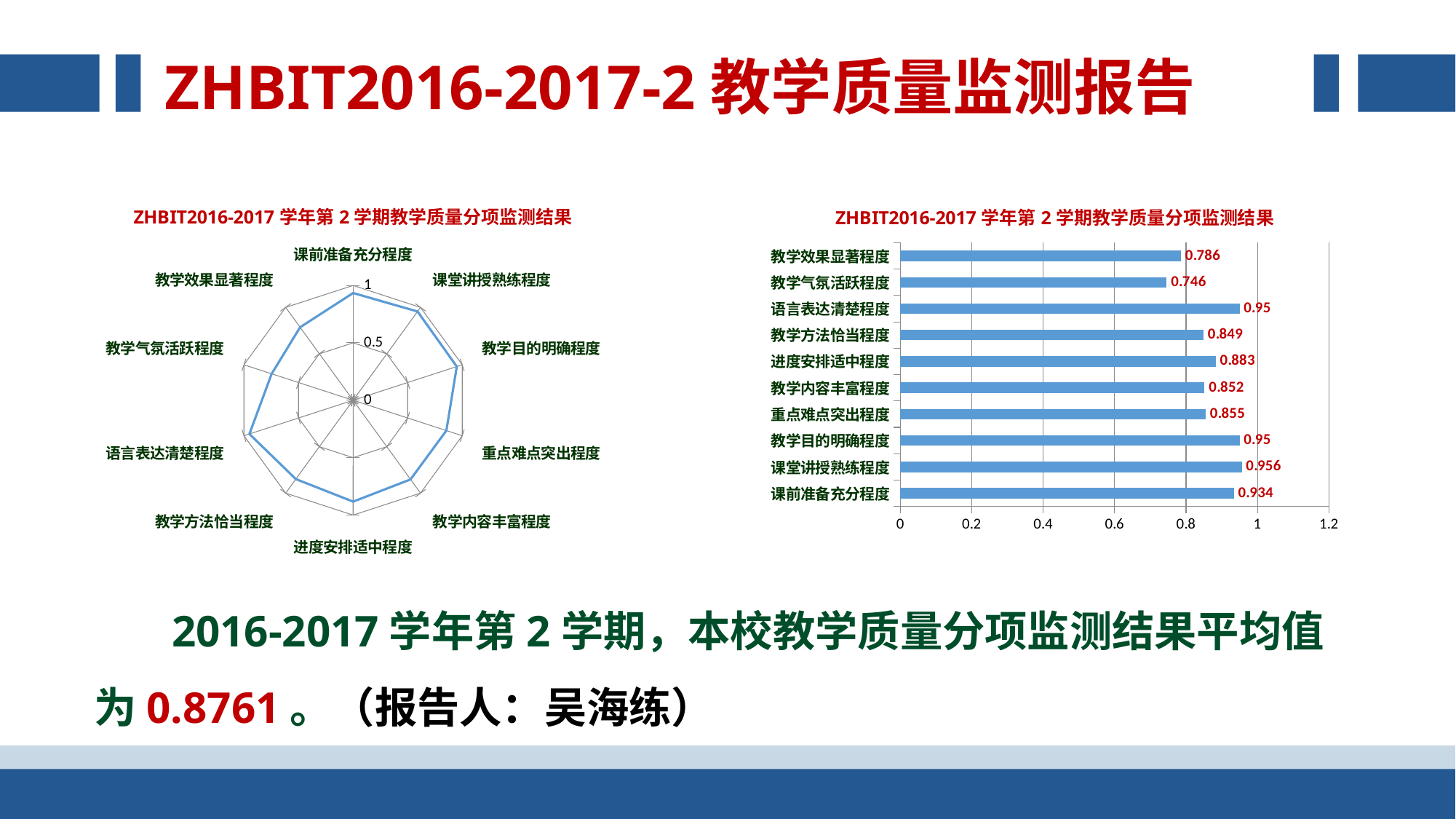
What kind of chart is the chart on the right side of the slide? bar chart In the bar chart on the right, what is the difference between the values for 进度安排适中程度 and 教学方法恰当程度? 0.034 In the bar chart on the right, is the value for 教学效果显著程度 greater or less than 0.8? less In the bar chart on the right, what is the value for 教学气氛活跃程度? 0.746 In the bar chart on the right, what is the value for 课前准备充分程度? 0.934 In the bar chart on the right, which category has the highest value? 课堂讲授熟练程度 What kind of chart is the chart on the left side of the slide? radar chart In the radar chart on the left, what is the maximum value shown on the axis scale? 1 In the bar chart on the right, which is larger: the value for 重点难点突出程度 or 教学内容丰富程度? 重点难点突出程度 In the bar chart on the right, which category has the lowest value? 教学气氛活跃程度 In the bar chart on the right, what is the value for 语言表达清楚程度? 0.95 How many categories are shown in the bar chart on the right? 10